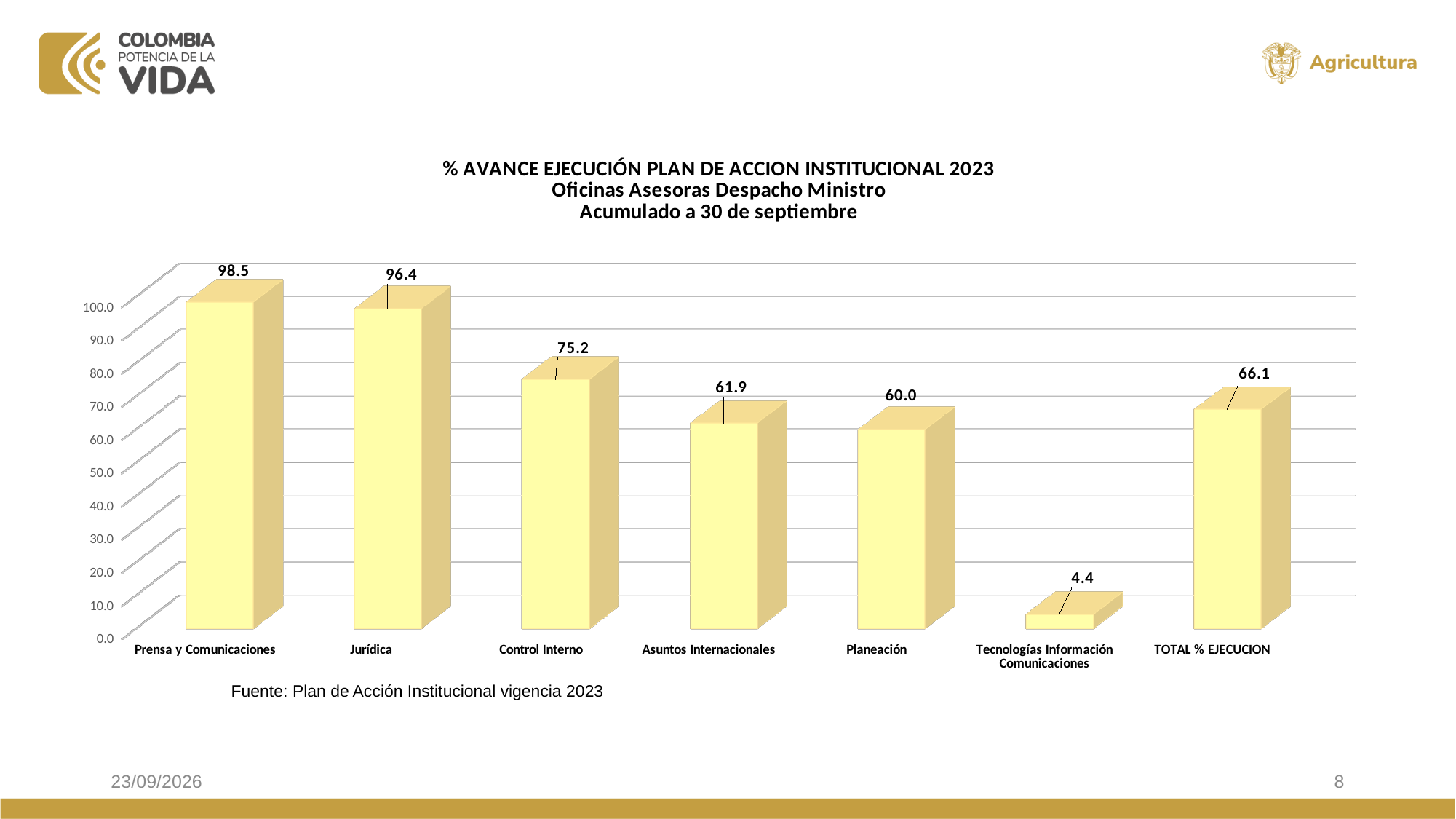
What is the source cited below the chart? Plan de Acción Institucional vigencia 2023 How many categories are shown on the x axis? 7 What kind of chart is shown on the slide? bar chart Which category has the highest value? Prensa y Comunicaciones Which is larger, the value for Asuntos Internacionales or the value for Planeación? Asuntos Internacionales Which category has the lowest value? Tecnologías Información Comunicaciones What is the value for Control Interno? 75.2 Is the value for Control Interno greater or less than 70.0? greater What is the value for Prensa y Comunicaciones? 98.5 What is the value for Tecnologías Información Comunicaciones? 4.4 What is the value for TOTAL % EJECUCION? 66.1 What is the difference between the values for Jurídica and Planeación? 36.4